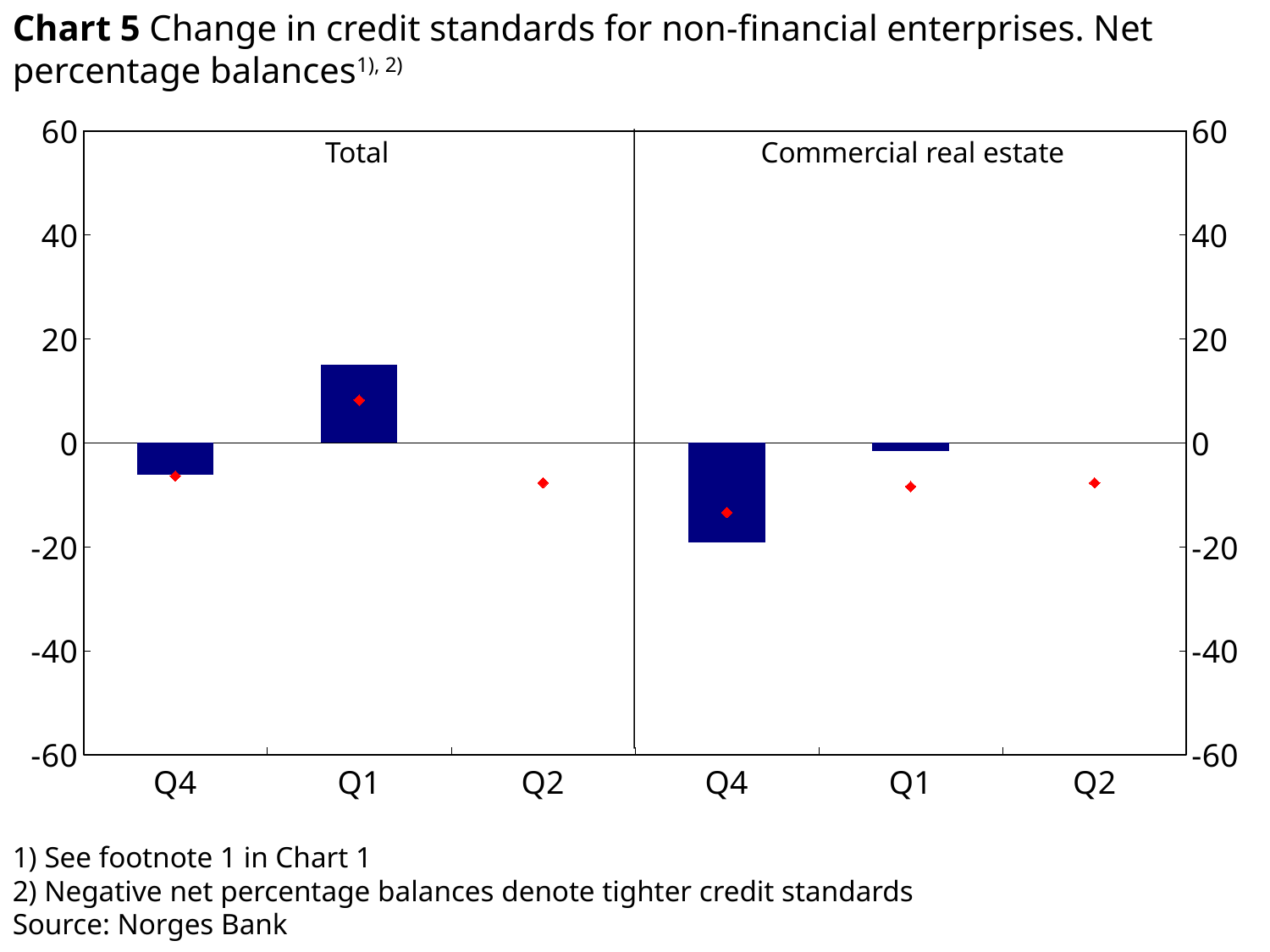
In the Commercial real estate panel, is the bar for Q4 greater or less than -10? less What is the range of the vertical axis? -60 to 60 Which Q4 bar is lower: the one in the Total panel or the one in the Commercial real estate panel? Commercial real estate How many quarters are labelled on the x axis of each panel? 3 In the Total panel, is the bar for Q4 greater or less than 0? less What kind of chart is Chart 5? bar chart In the Total panel, which quarter has the highest bar? Q1 In the Total panel, is the bar for Q1 greater or less than 0? greater What are the names of the two panels in the chart? Total and Commercial real estate In the Commercial real estate panel, which quarter has the lowest bar? Q4